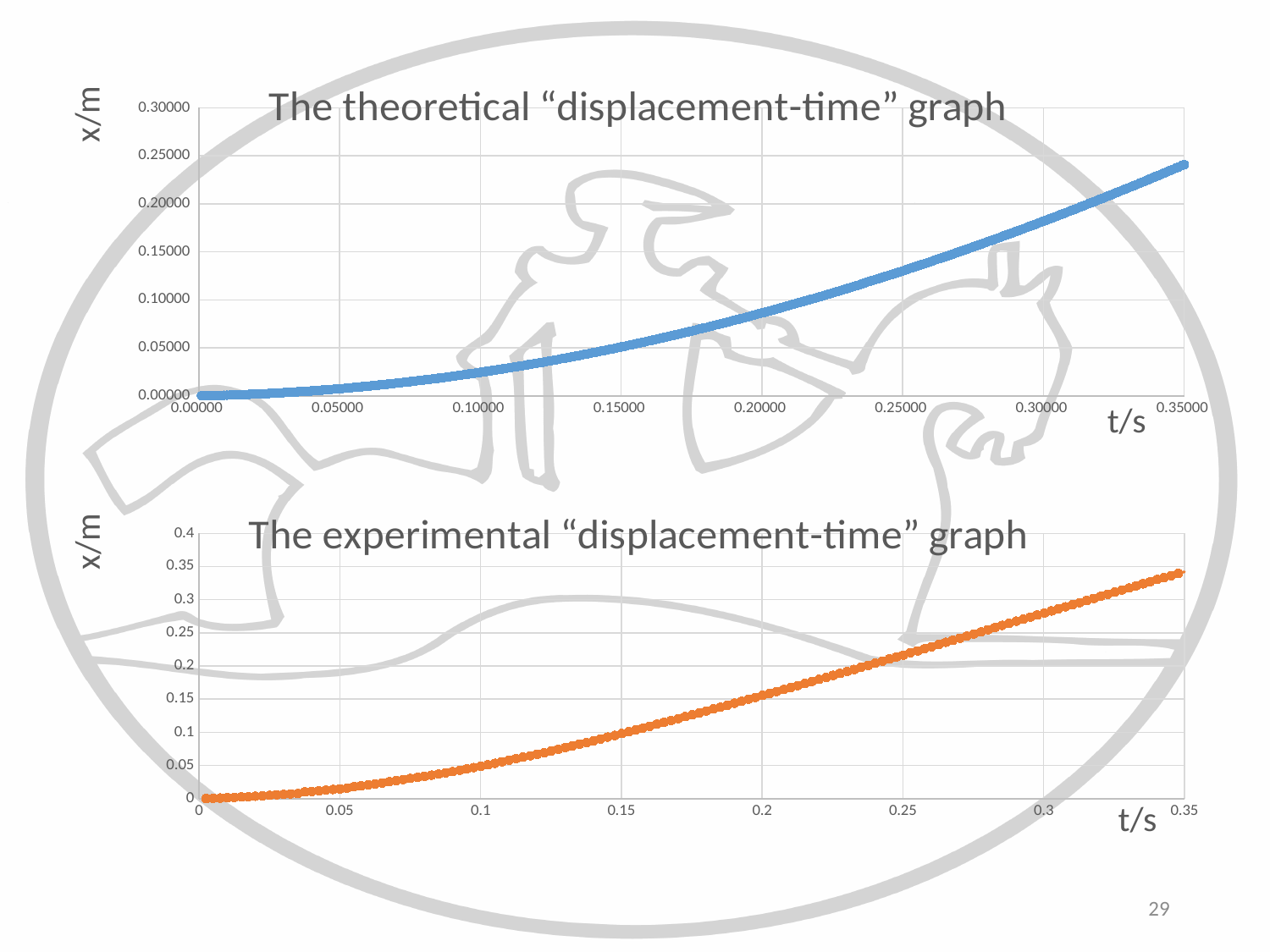
In the experimental "displacement-time" graph, does the displacement rise or fall as time increases? rise In the theoretical "displacement-time" graph, is the value of x at t = 0.10000 s greater or less than 0.05000? less What kind of chart is the experimental "displacement-time" graph? scatter chart In the experimental "displacement-time" graph, is the value of x at t = 0.35 s greater or less than 0.3? greater In the theoretical "displacement-time" graph, is the value of x at t = 0.35000 s greater or less than 0.25000? less What is the label on the vertical axis of the theoretical "displacement-time" graph? x/m In the theoretical "displacement-time" graph, does the displacement rise or fall as time increases? rise At t = 0.35 s, which chart shows the larger displacement: the theoretical graph or the experimental graph? the experimental graph